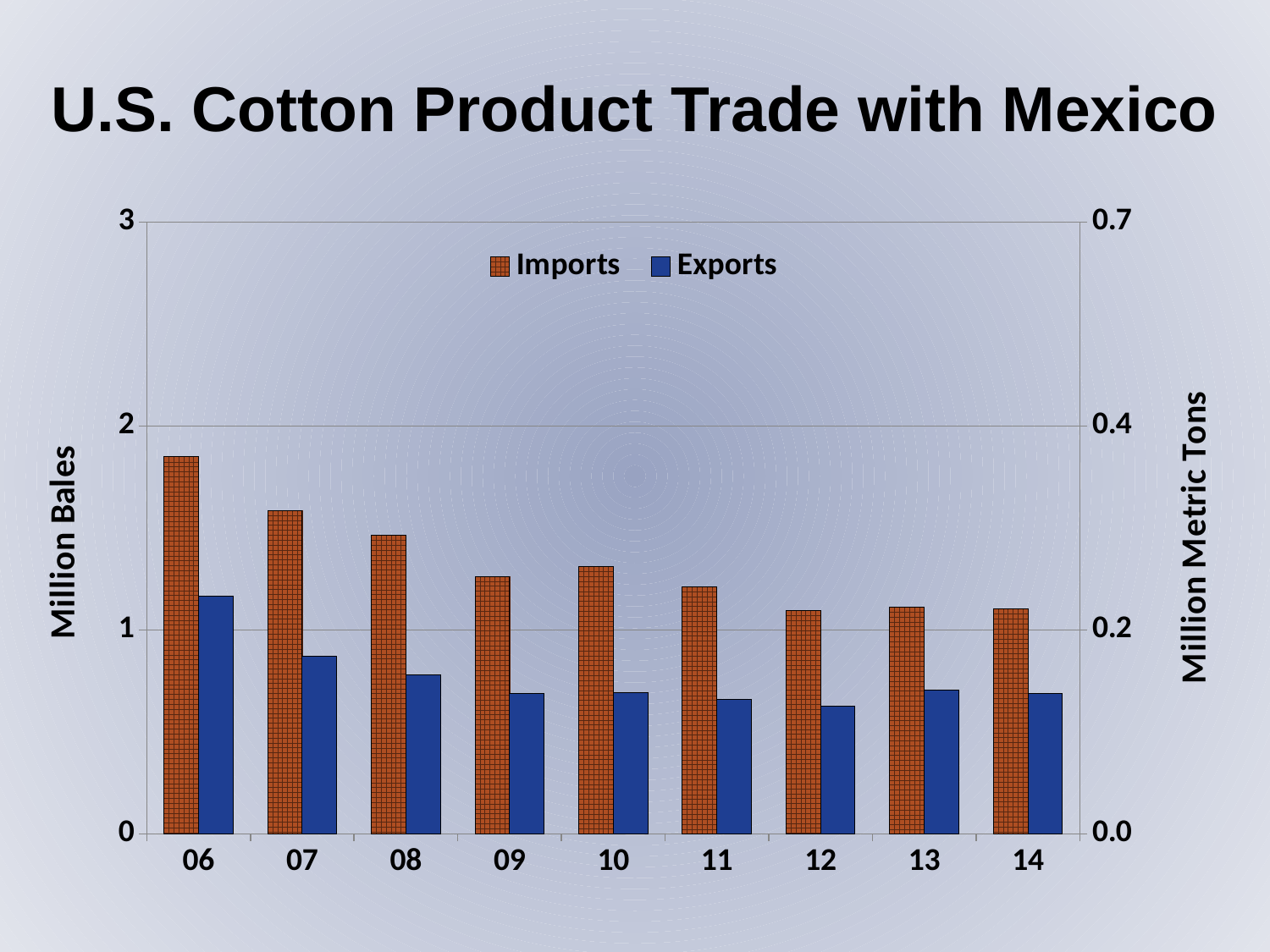
Do the Imports values generally rise or fall from 06 to 14? fall How many series does the legend list? 2 Which year has the highest Exports value? 06 What is the label on the left vertical axis? Million Bales How many years are shown on the x axis? 9 Which year has the highest Imports value? 06 Is the Imports value for 07 greater or less than 2 million bales? less Is the Exports value for 07 greater or less than 1 million bales? less Is the Exports value for 06 greater or less than 1 million bales? greater What kind of chart is shown on the slide? bar chart Which is larger, the Imports value for 08 or the Imports value for 09? 08